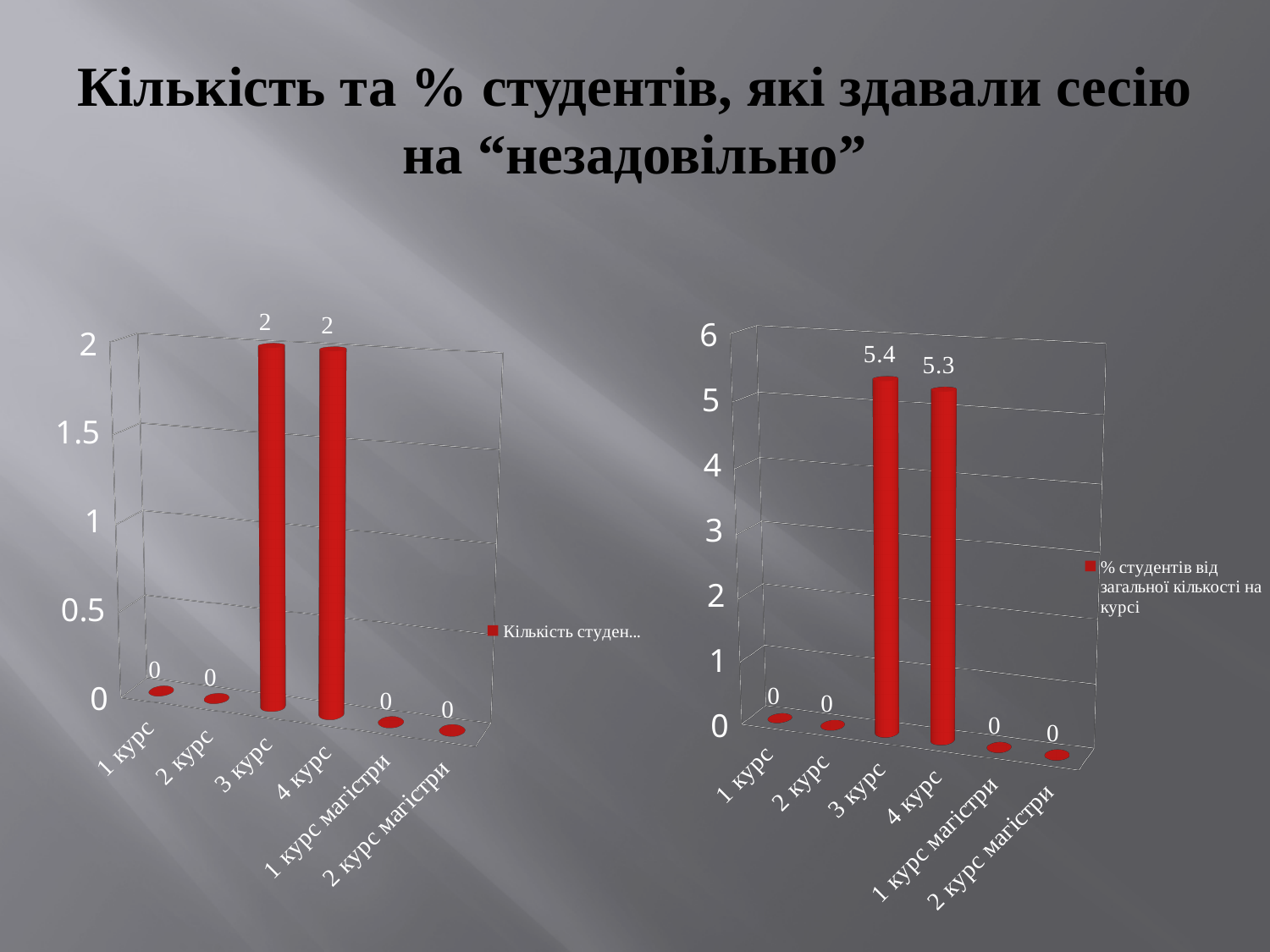
What is the legend entry of the right chart? % студентів від загальної кількості на курсі In the right chart, is the value for 3 курс greater or less than 5? greater In the right chart, what is the value for 4 курс? 5.3 In the right chart, what is the value for 1 курс магістри? 0 In the left chart, what is the value for 3 курс? 2 In the right chart, what is the difference between the values for 3 курс and 4 курс? 0.1 In the right chart, how many categories have a value of 0? 4 In the left chart, how many categories are shown on the x axis? 6 In the right chart, which category has the highest value? 3 курс What type of chart is the left chart? Bar chart In the left chart, what is the value for 4 курс? 2 In the right chart, what is the value for 3 курс? 5.4